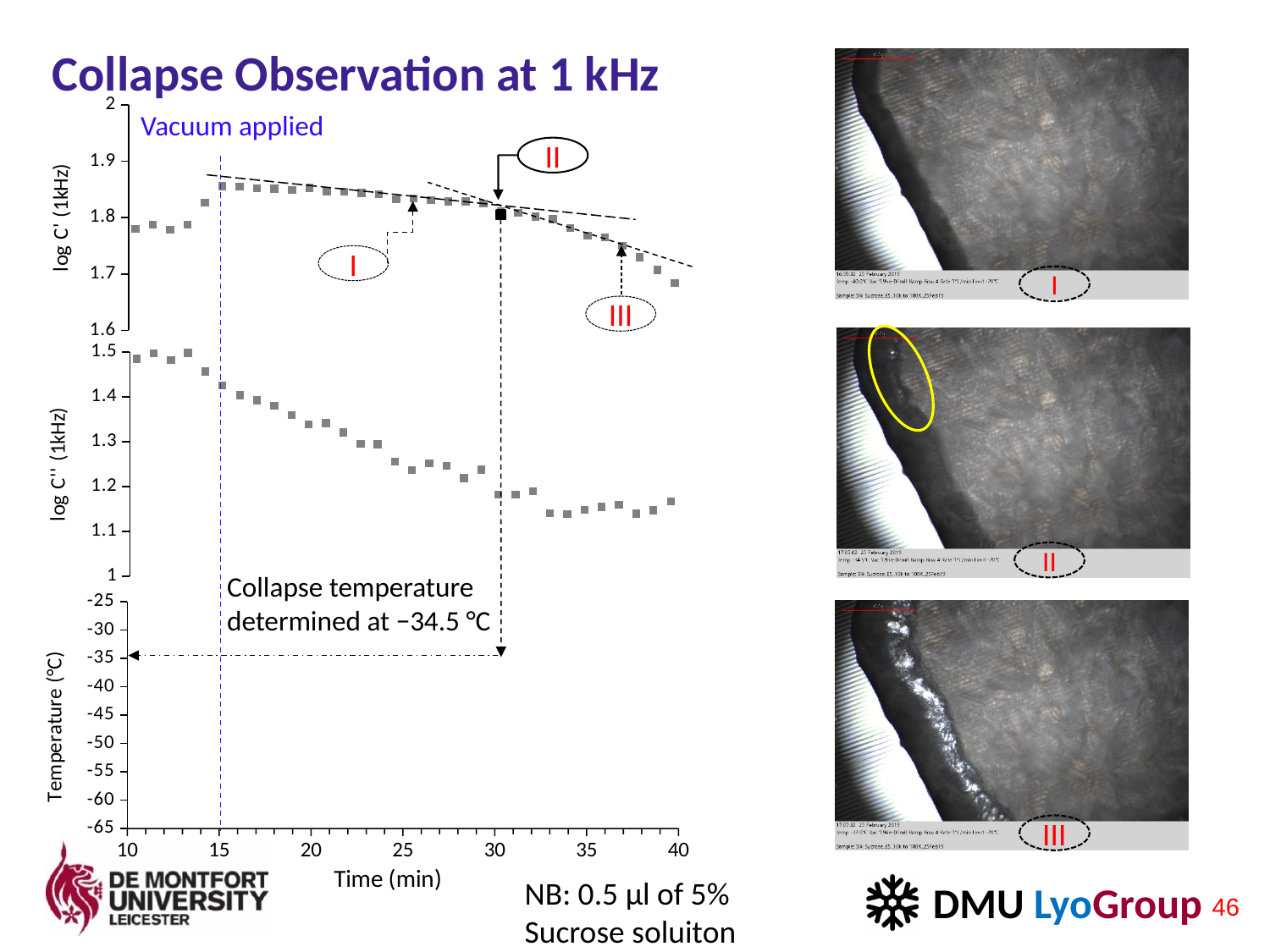
Is the log C' (1kHz) value at 40 min greater or less than 1.7? less What kind of chart is shown on the left of the slide? scatter chart How many stacked panels (y axes) does the chart have? 3 Is the log C' (1kHz) value at 15 min greater or less than 1.8? greater Is the log C'' (1kHz) value at 40 min greater or less than 1.3? less At what collapse temperature was the collapse determined, according to the chart annotation? −34.5 °C What is the y-axis label of the top panel of the chart? log C' (1kHz) Do the log C'' (1kHz) values rise or fall along the x axis after the vacuum is applied at 15 min? fall What is the lowest tick value shown on the Temperature (°C) axis? -65 How many labelled stages (Roman numerals) are marked on the chart? 3 What is the label of the x axis of the chart? Time (min) At what time (min) is the 'Vacuum applied' dashed line drawn on the chart? 15